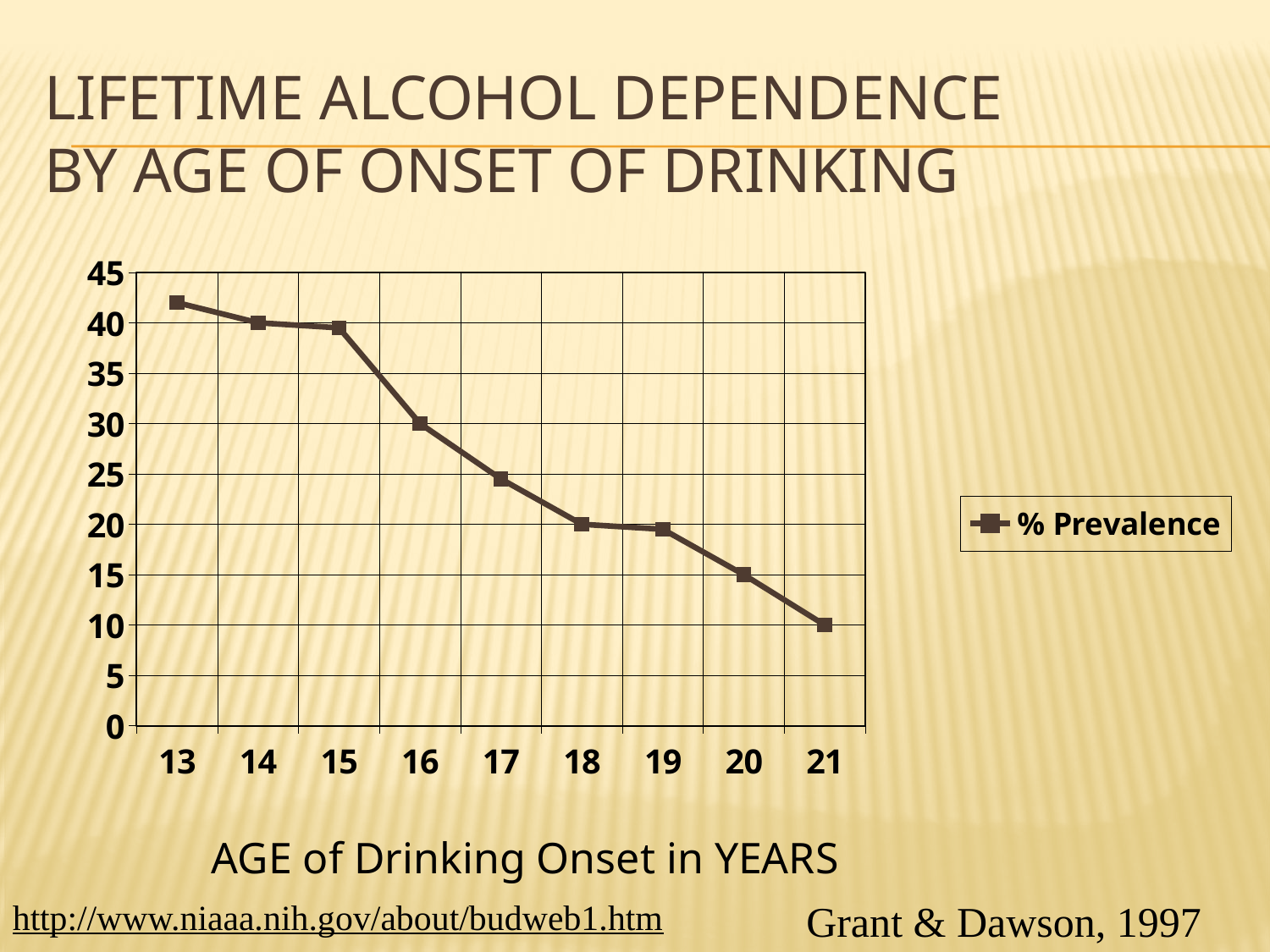
How many age categories are plotted along the x axis? 9 What is the % Prevalence for age of onset 21? 10 Is the % Prevalence for age of onset 13 greater or less than 40? greater Do the % Prevalence values rise or fall as age of drinking onset increases? fall What is the name of the series shown in the legend? % Prevalence Which age of drinking onset has the highest % Prevalence? 13 What is the % Prevalence for age of onset 16? 30 What kind of chart is shown on the slide? line chart How many series does the legend list? 1 Which has a higher % Prevalence, age of onset 16 or age of onset 18? 16 Which age of drinking onset has the lowest % Prevalence? 21 Is the % Prevalence for age of onset 17 greater or less than 30? less